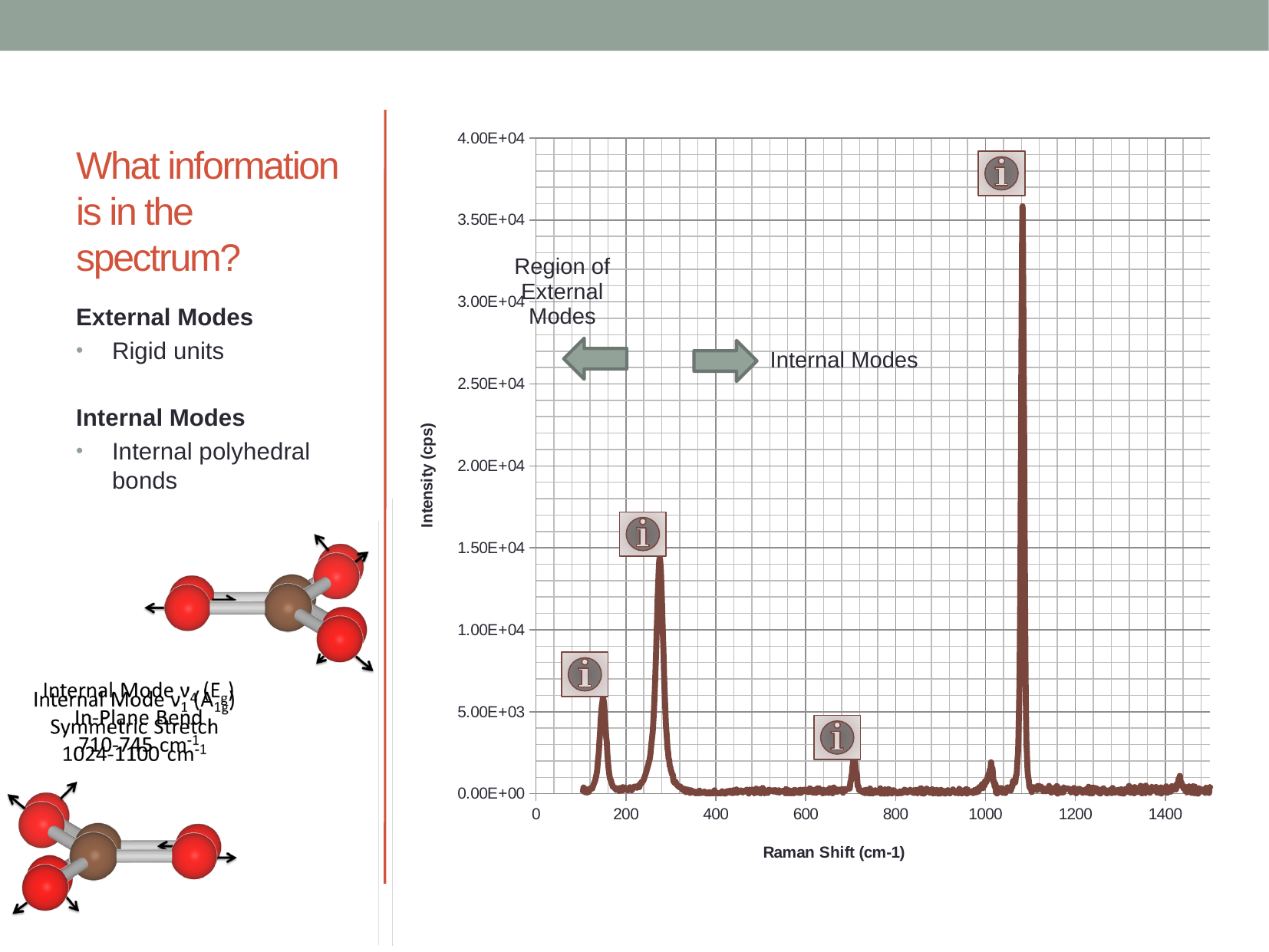
What kind of chart is shown on the slide? line chart What is the title of the y axis of the chart? Intensity (cps) What is the title of the x axis of the chart? Raman Shift (cm-1) Is the intensity of the peak near a Raman shift of 275 cm-1 greater or less than 1.00E+04? greater What is the highest value labelled on the x axis of the chart? 1400 Is the intensity of the peak near a Raman shift of 710 cm-1 greater or less than 5.00E+03? less Is the intensity of the peak near a Raman shift of 150 cm-1 greater or less than 1.00E+04? less Which peak is taller: the one near 150 cm-1 or the one near 275 cm-1? the one near 275 cm-1 What is the highest value labelled on the y axis of the chart? 4.00E+04 How many labelled tick marks are there on the x axis of the chart? 8